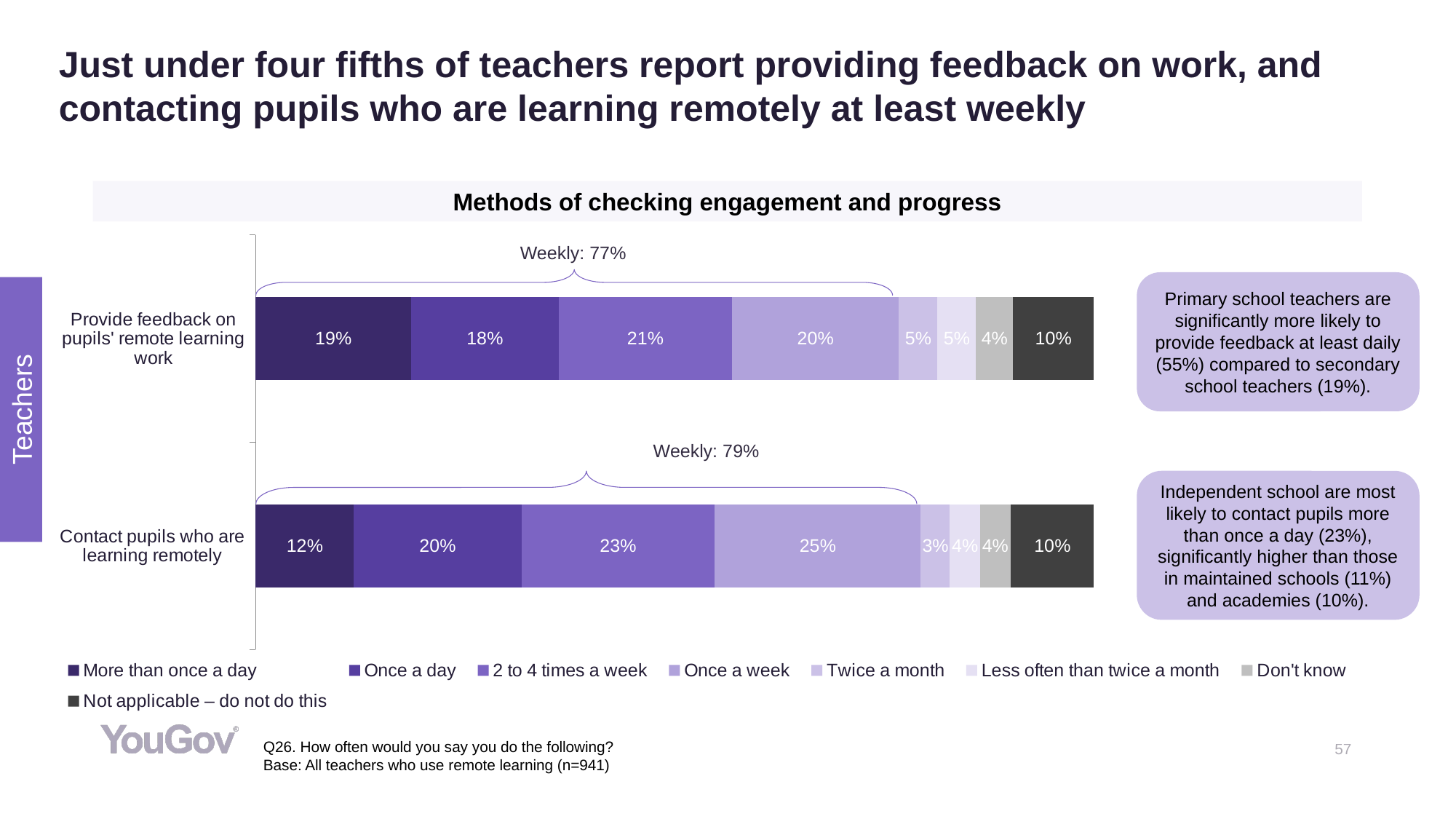
What percentage of teachers contact pupils who are learning remotely once a week? 25% What is the difference between the 'More than once a day' shares for providing feedback (19%) and contacting pupils (12%)? 7 percentage points What is the 'Weekly' figure shown above the 'Contact pupils who are learning remotely' bar? 79% Which is larger: the 'Once a day' share for providing feedback on remote learning work or for contacting pupils learning remotely? Contact pupils who are learning remotely Which response category has the largest share for 'Provide feedback on pupils' remote learning work'? 2 to 4 times a week What is the 'Weekly' figure shown above the 'Provide feedback on pupils' remote learning work' bar? 77% How many categories (bars) are shown in the chart? 2 What percentage of teachers provide feedback on pupils' remote learning work more than once a day? 19% How many series does the legend list? 8 What percentage of teachers say 'Not applicable – do not do this' for contacting pupils who are learning remotely? 10% Which response category has the largest share for 'Contact pupils who are learning remotely'? Once a week What type of chart is used on this slide? Stacked bar chart